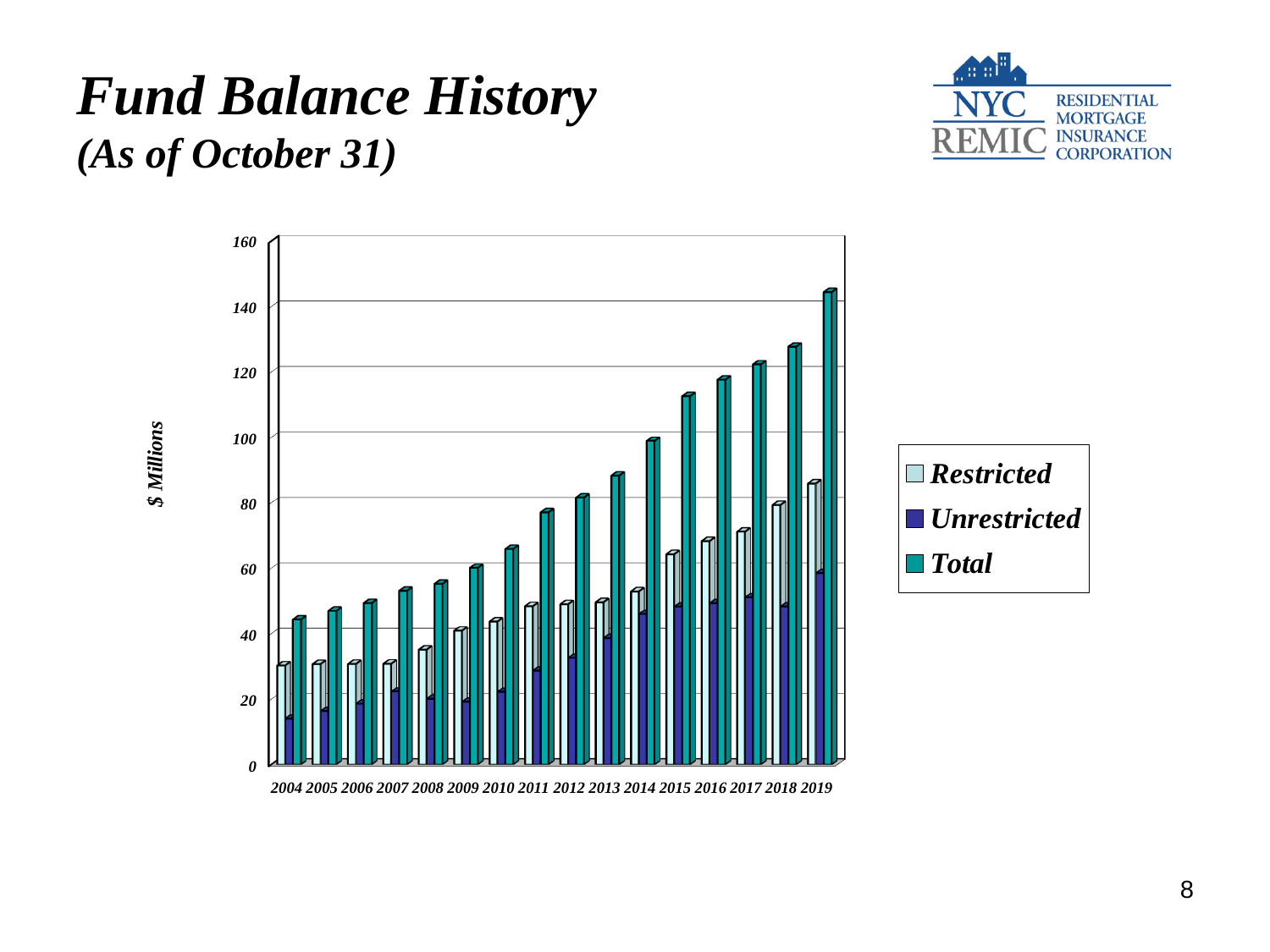
How many years are shown on the x axis? 16 In which year is the Unrestricted fund balance lowest? 2004 Is the Restricted value for 2019 greater or less than 80? greater Is the Total value for 2019 greater or less than 120? greater Which is larger in 2010, the Restricted value or the Unrestricted value? Restricted Is the Total value for 2004 greater or less than 60? less What kind of chart is shown on the slide? bar chart What is the label on the vertical axis? $ Millions How many series does the legend list? 3 In which year is the Total fund balance highest? 2019 Does the Total fund balance rise or fall from 2004 to 2019? rise